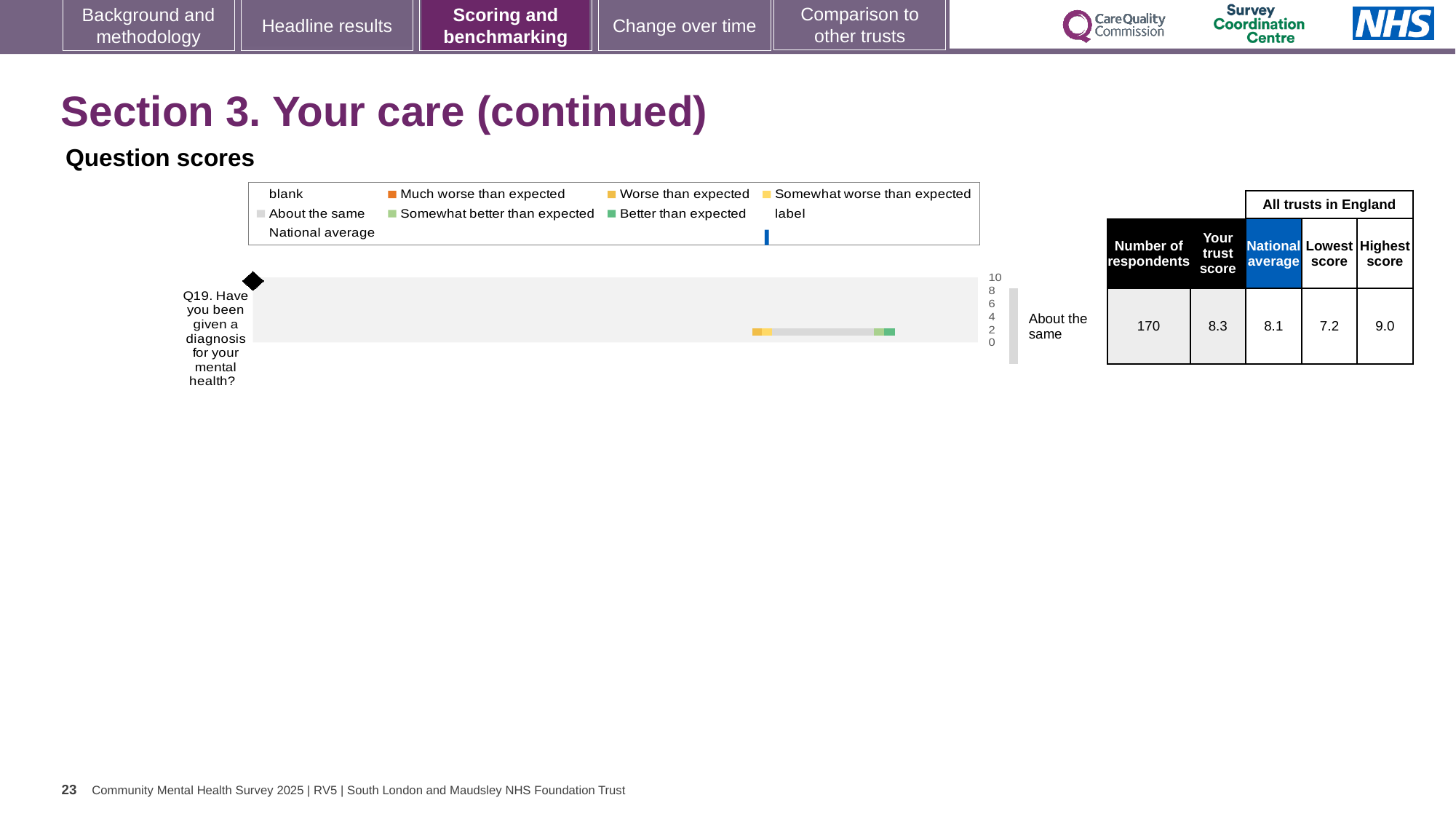
What is the number of respondents for Q19? 170 Which is larger for Q19, the trust score or the national average? trust score What kind of chart is used to show the Q19 question score? bar chart What is the national average for Q19? 8.1 Which question is plotted on the chart? Q19. Have you been given a diagnosis for your mental health? What is the difference between the highest and lowest scores for Q19? 1.8 What is the highest score among all trusts in England for Q19? 9.0 What is the heading above the chart? Question scores What is the lowest score among all trusts in England for Q19? 7.2 What is the trust score for Q19? 8.3 How many questions are plotted on the chart? 1 What benchmark category is shown for Q19? About the same